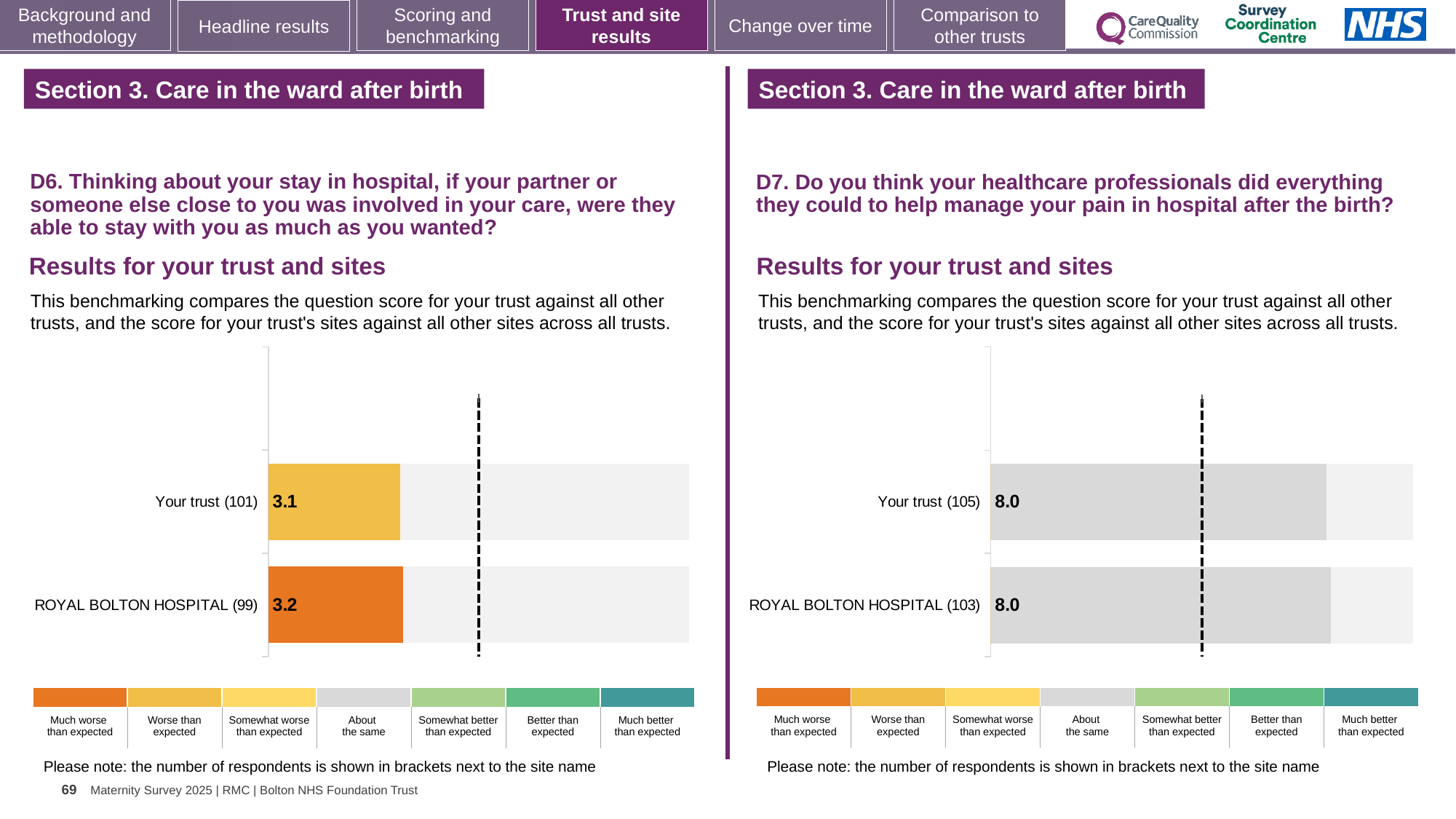
On the D7 chart, what is the score for Your trust? 8.0 On the D7 chart, how many respondents are shown in brackets for Your trust? 105 On the D6 chart, what is the score for ROYAL BOLTON HOSPITAL? 3.2 On the D6 chart, what is the difference between the ROYAL BOLTON HOSPITAL score and the Your trust score? 0.1 On the D6 chart, how many respondents are shown in brackets for ROYAL BOLTON HOSPITAL? 99 On the D7 chart, what is the difference between the Your trust score and the ROYAL BOLTON HOSPITAL score? 0.0 How many bars are plotted on the D7 chart? 2 On the D6 chart, which has the higher score, Your trust or ROYAL BOLTON HOSPITAL? ROYAL BOLTON HOSPITAL What type of chart is used for the D6 results? Bar chart On the D6 chart, what is the score for Your trust? 3.1 On the D7 chart, what is the score for ROYAL BOLTON HOSPITAL? 8.0 How many bars are plotted on the D6 chart? 2